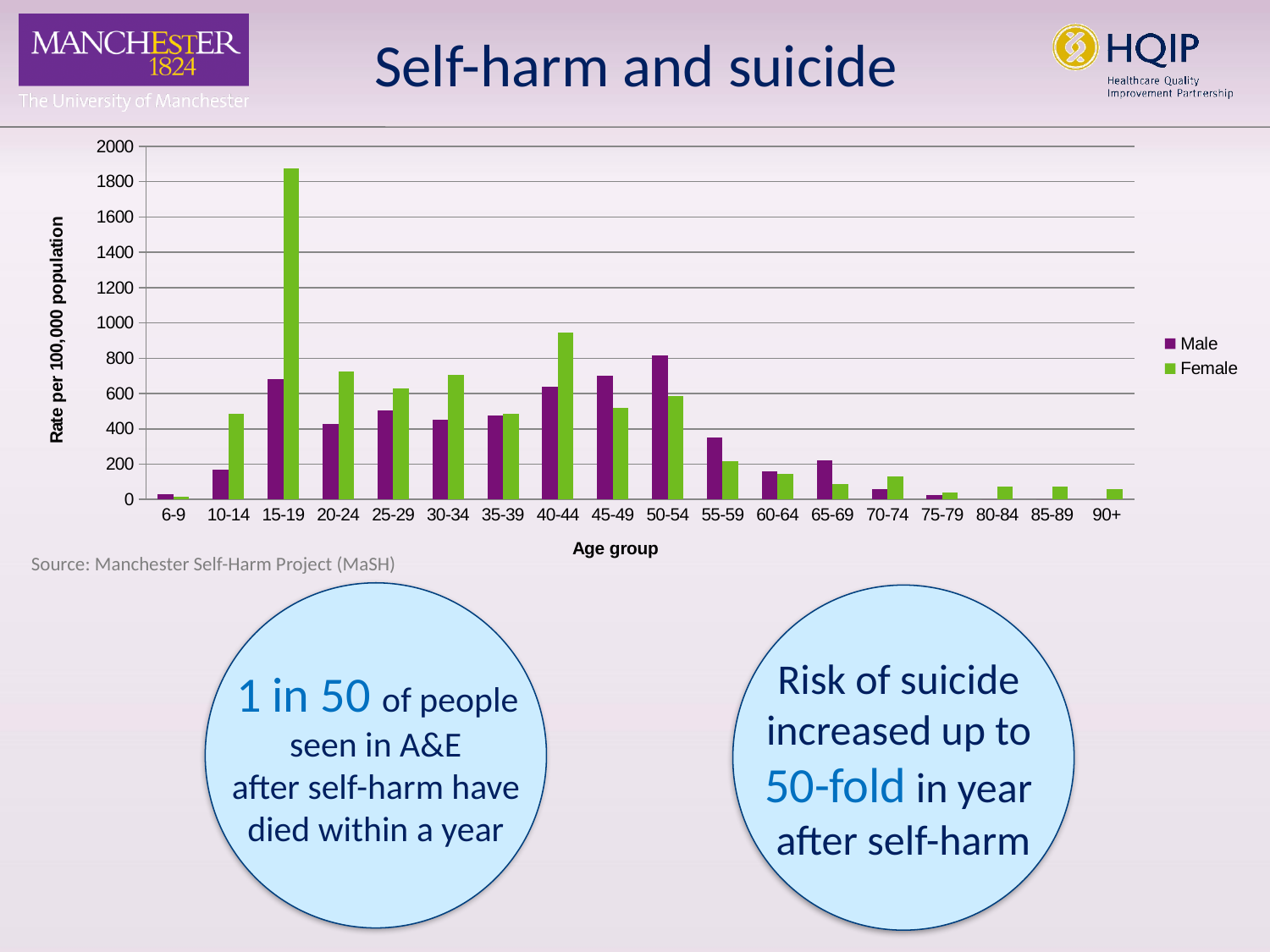
Is the Male value for the 6-9 age group greater or less than 200? less Which age group has the highest Female rate? 15-19 Is the Male value for the 55-59 age group greater or less than 400? less Is the Female value for the 15-19 age group greater or less than 1800? greater How many age groups are shown on the x axis of the chart? 18 How many series does the chart legend list? 2 In the 50-54 age group, which series has the larger value, Male or Female? Male What kind of chart is shown on the slide? Bar chart What is the label of the chart's vertical axis? Rate per 100,000 population In the 15-19 age group, which series has the larger value, Male or Female? Female Which age group has the highest Male rate? 50-54